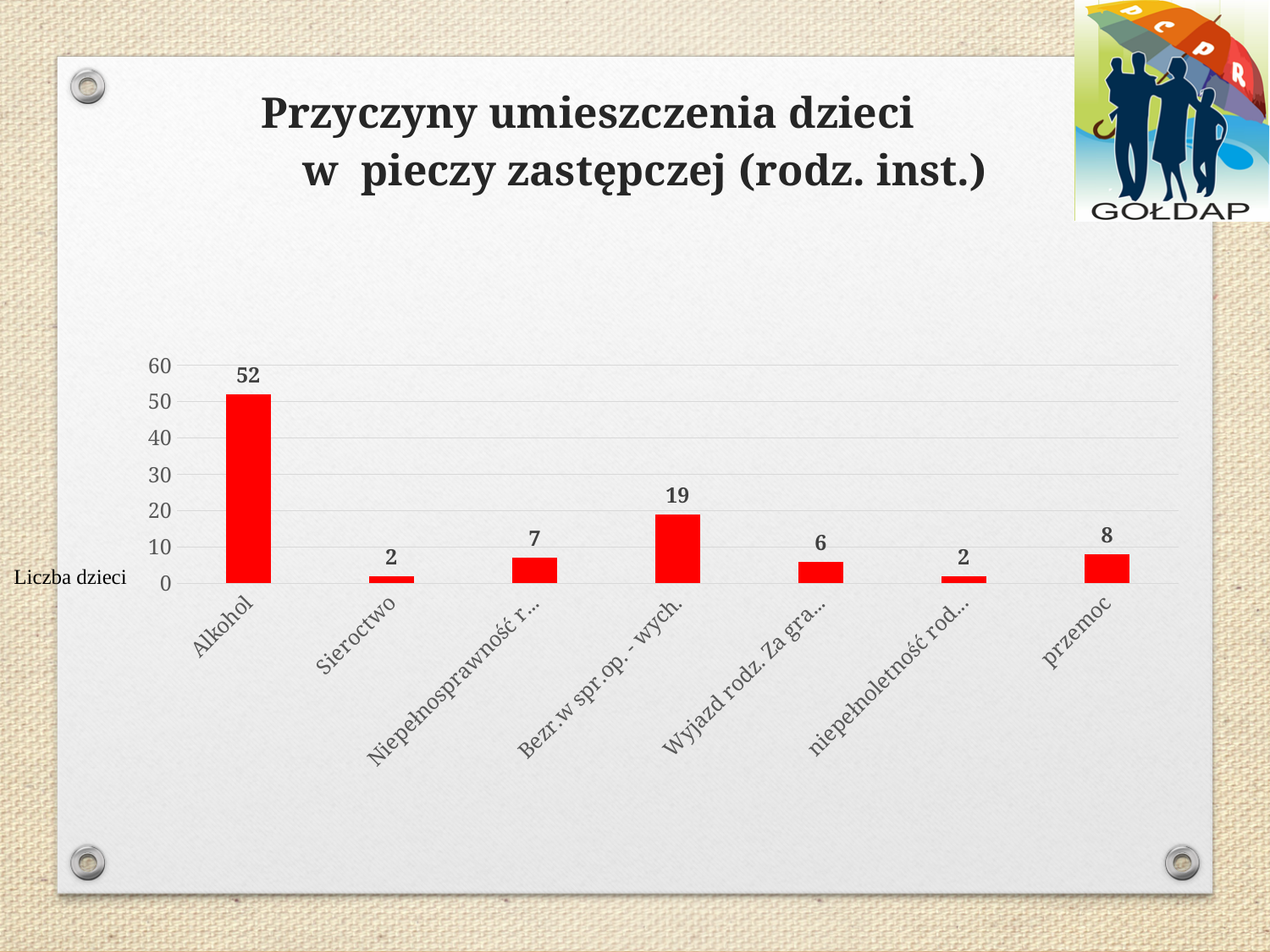
What is the lowest value shown in the chart? 2 What is the value for Sieroctwo? 2 What is the value for Alkohol? 52 Is the value for Alkohol greater or less than 50? greater What type of chart is shown on the slide? bar chart How many categories are shown in the chart? 7 Which category has the highest value? Alkohol What is the value for przemoc? 8 What is the value for Bezr.w spr.op.- wych.? 19 What is the label of the vertical axis? Liczba dzieci Which is larger, the value for przemoc or the value for Sieroctwo? przemoc What is the difference between the values for Alkohol and Bezr.w spr.op.- wych.? 33